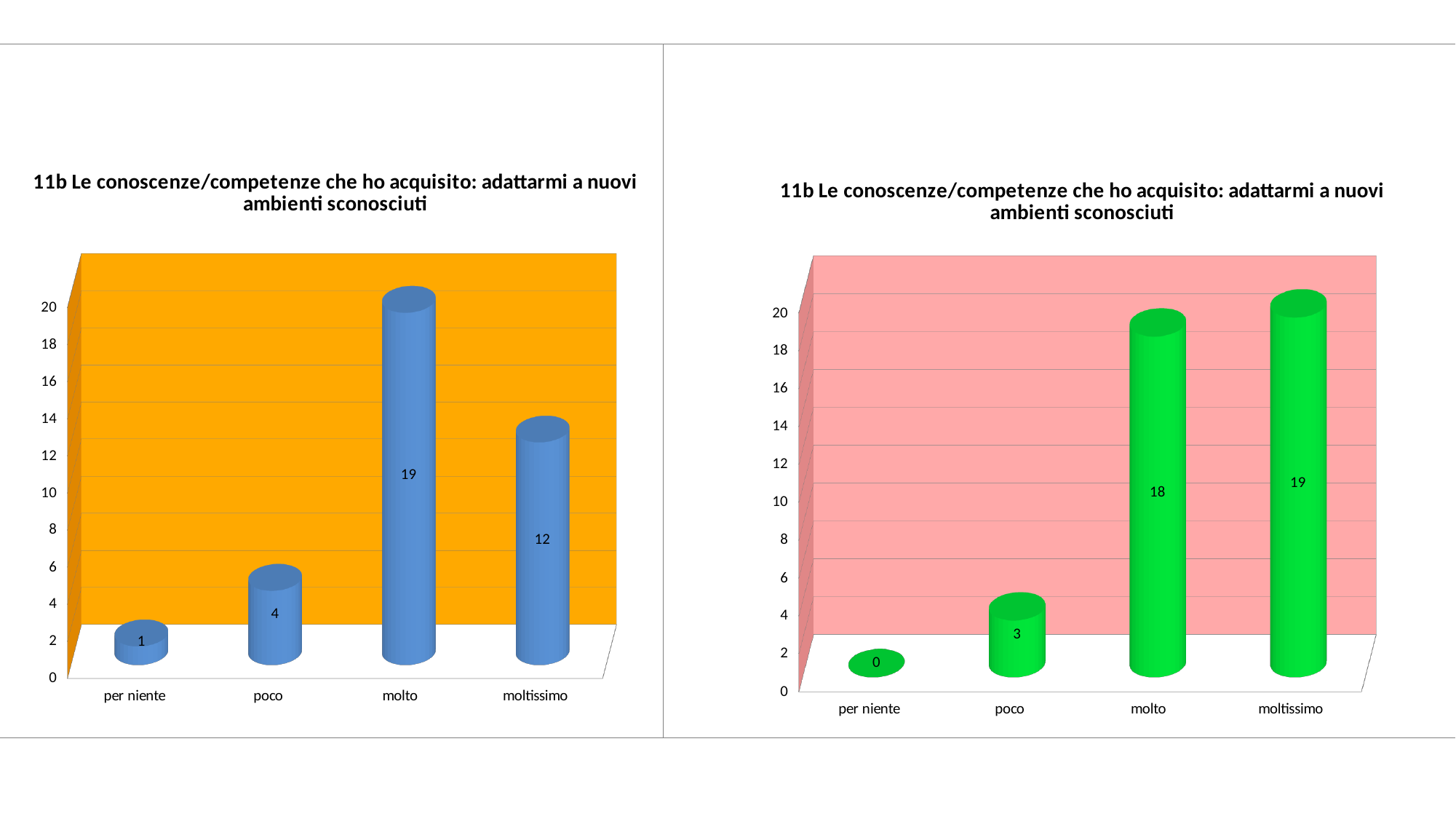
How many categories are shown on the x axis of the right chart? 4 In the left chart, what is the difference between the values for "molto" and "moltissimo"? 7 In the right chart, what is the value for "per niente"? 0 What colour are the bars in the right chart? green In the right chart, which is larger, the value for "molto" or the value for "poco"? molto In the left chart, is the value for "moltissimo" greater or less than 10? greater In the left chart, which category has the lowest value? per niente In the left chart, what is the value for "molto"? 19 In the left chart, what is the value for "per niente"? 1 In the right chart, which category has the highest value? moltissimo In the right chart, what is the value for "poco"? 3 What kind of chart is the left chart? bar chart